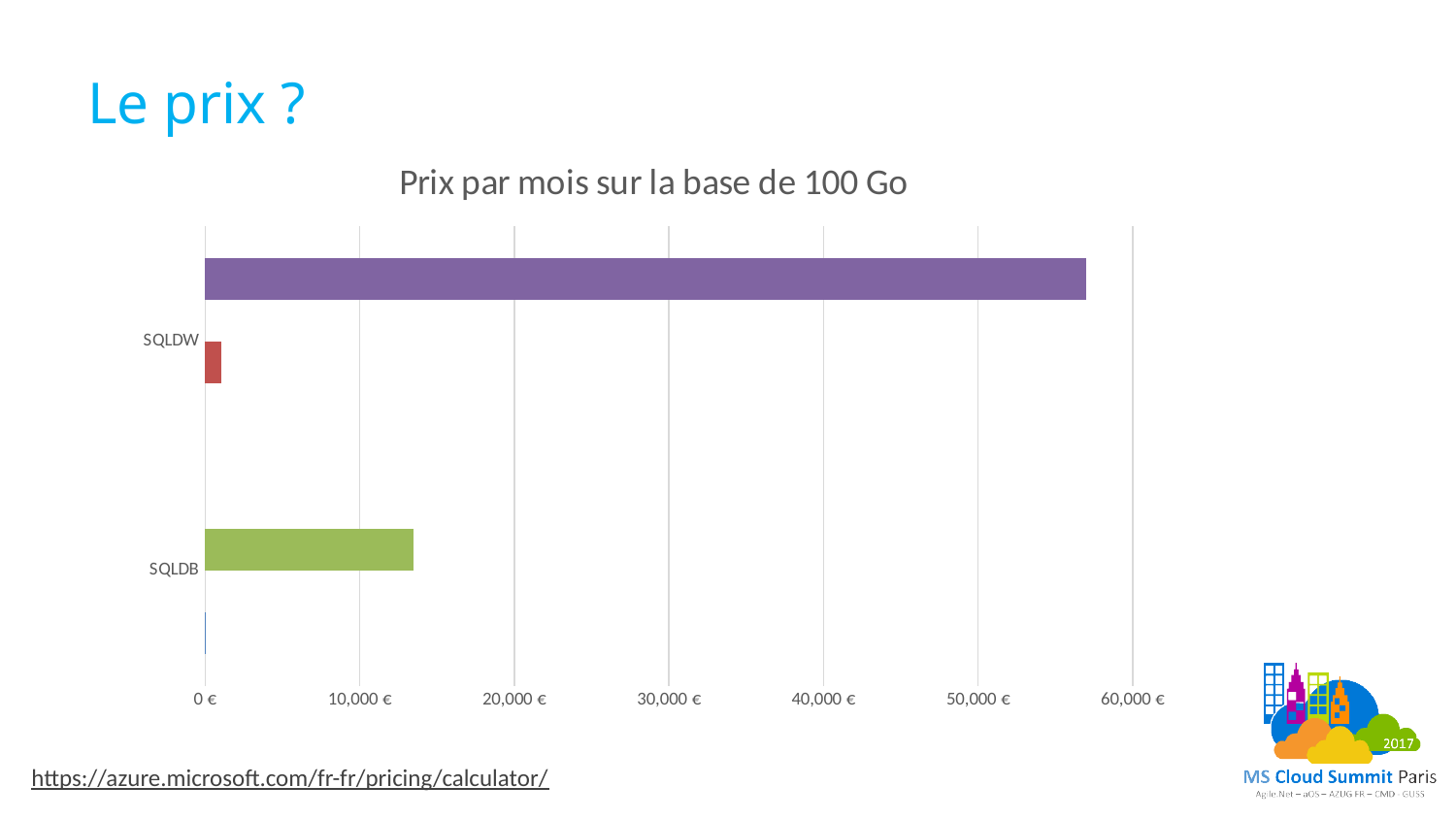
Which category contains the longest bar in the chart? SQLDW Which is larger: the red bar for SQLDW or the green bar for SQLDB? the green bar for SQLDB Is the value of the green bar for SQLDB greater or less than 10,000 €? greater How many categories are shown on the vertical axis of the chart? 2 What is the title of the chart? Prix par mois sur la base de 100 Go Is the value of the red bar for SQLDW greater or less than 10,000 €? less What kind of chart is shown on the slide? bar chart Is the value of the purple bar for SQLDW greater or less than 50,000 €? greater What is the highest value labelled on the horizontal axis of the chart? 60,000 € Which is larger: the purple bar for SQLDW or the green bar for SQLDB? the purple bar for SQLDW